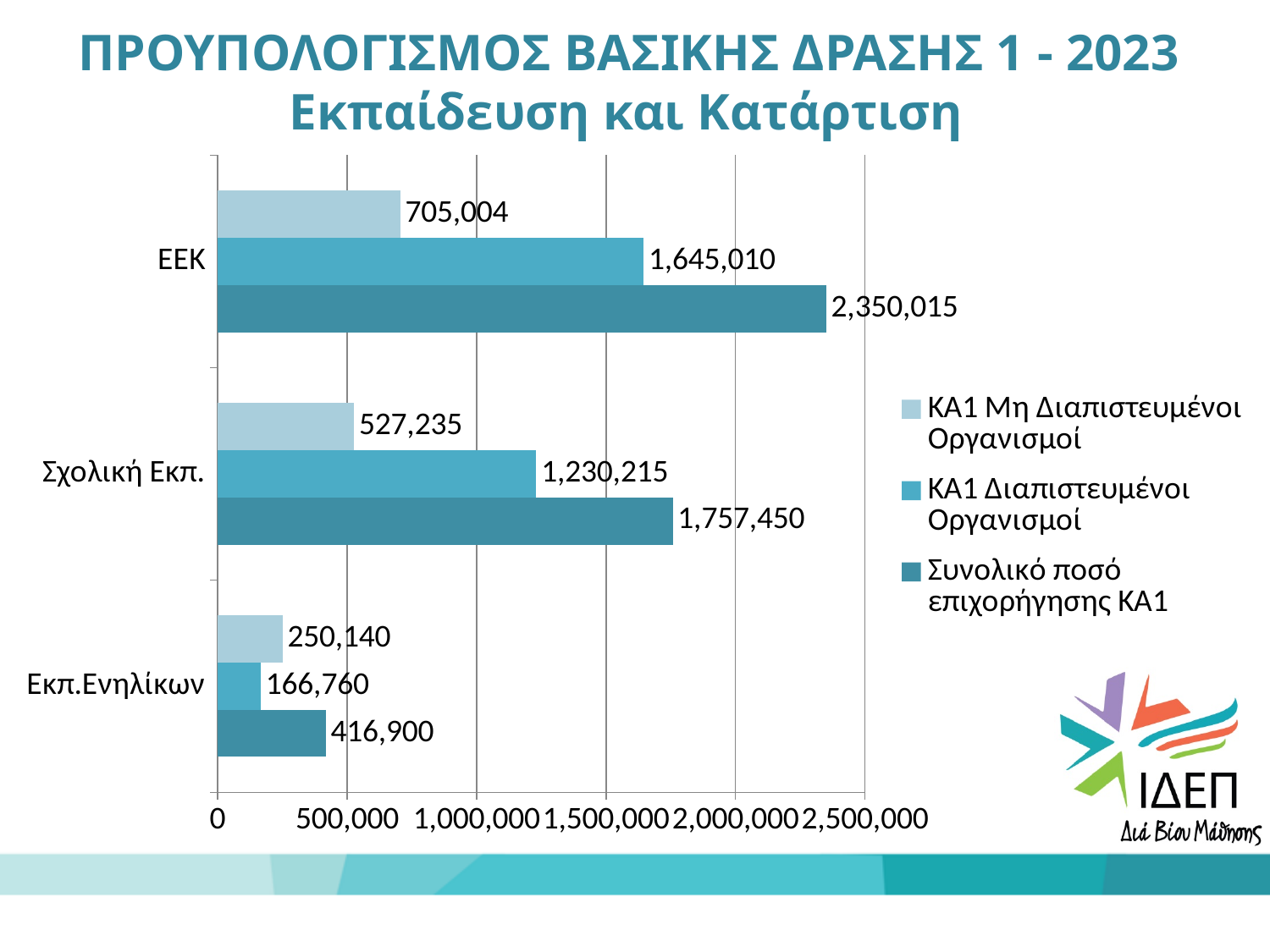
Which category has the highest value for Συνολικό ποσό επιχορήγησης ΚΑ1? ΕΕΚ Which category has the lowest value for ΚΑ1 Διαπιστευμένοι Οργανισμοί? Εκπ.Ενηλίκων How many categories are shown on the chart? 3 How many series does the legend list? 3 What is the difference between the Συνολικό ποσό επιχορήγησης ΚΑ1 values for ΕΕΚ and Σχολική Εκπ.? 592,565 What is the value of Συνολικό ποσό επιχορήγησης ΚΑ1 for ΕΕΚ? 2,350,015 What is the value of ΚΑ1 Μη Διαπιστευμένοι Οργανισμοί for Σχολική Εκπ.? 527,235 What is the difference between the ΚΑ1 Μη Διαπιστευμένοι Οργανισμοί and ΚΑ1 Διαπιστευμένοι Οργανισμοί values for Εκπ.Ενηλίκων? 83,380 What is the value of ΚΑ1 Διαπιστευμένοι Οργανισμοί for Εκπ.Ενηλίκων? 166,760 What kind of chart is shown on the slide? Bar chart Is the value of ΚΑ1 Διαπιστευμένοι Οργανισμοί for ΕΕΚ greater or less than 1,500,000? greater For Σχολική Εκπ., which is larger: ΚΑ1 Διαπιστευμένοι Οργανισμοί or ΚΑ1 Μη Διαπιστευμένοι Οργανισμοί? ΚΑ1 Διαπιστευμένοι Οργανισμοί